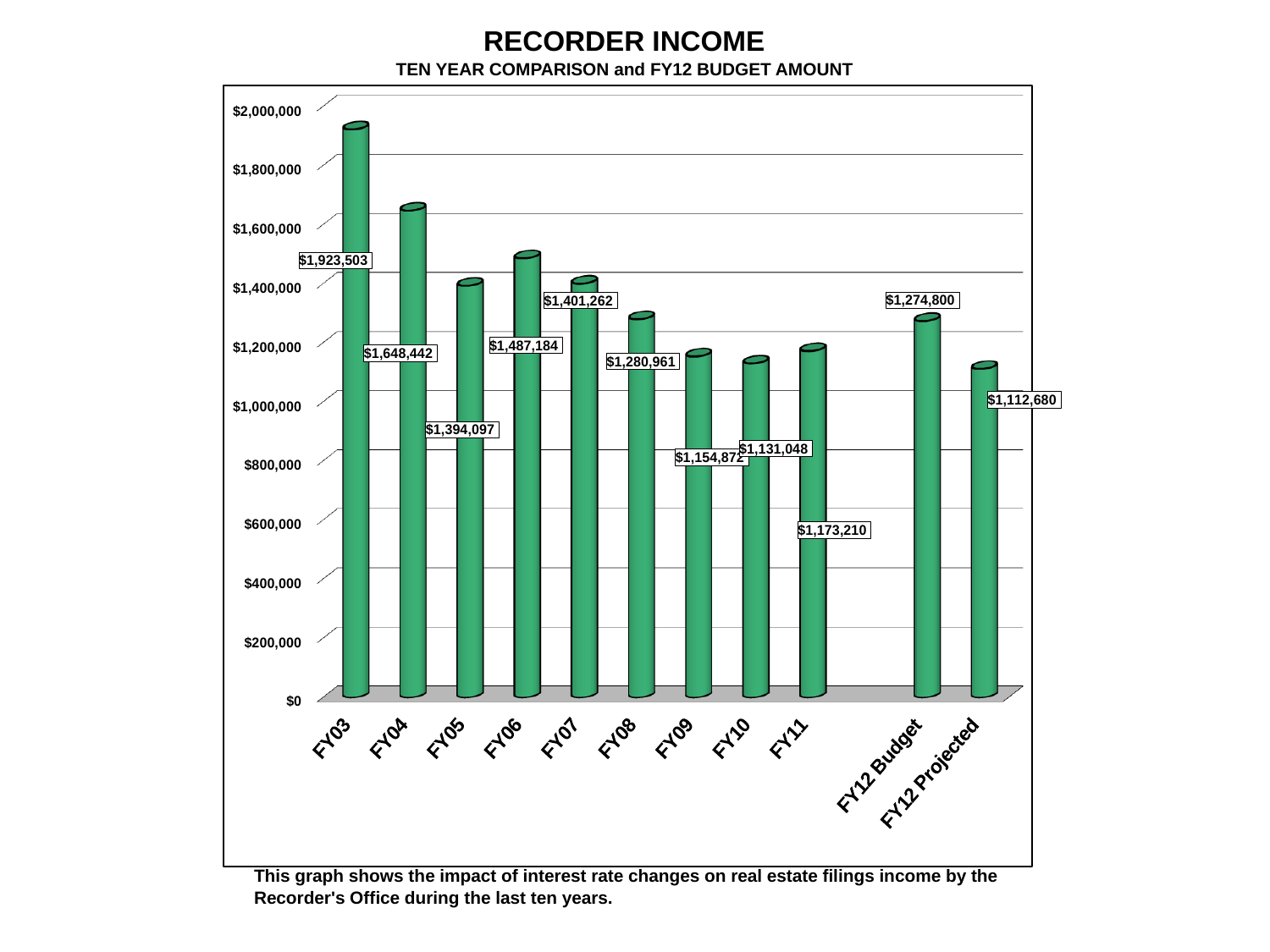
What is the Recorder income value for FY03? $1,923,503 What is the value shown for FY12 Projected? $1,112,680 What is the value shown for FY08? $1,280,961 Which fiscal year has the highest Recorder income? FY03 What is the difference between the FY03 and FY04 values? $275,061 How many categories are shown on the x axis? 11 Which is larger, the value for FY06 or the value for FY07? FY06 Which category has the lowest value on the chart? FY12 Projected Is the value for FY05 greater or less than $1,200,000? greater What is the value shown for FY12 Budget? $1,274,800 What kind of chart is shown on the slide? Bar chart What is the difference between the FY12 Budget and FY12 Projected values? $162,120